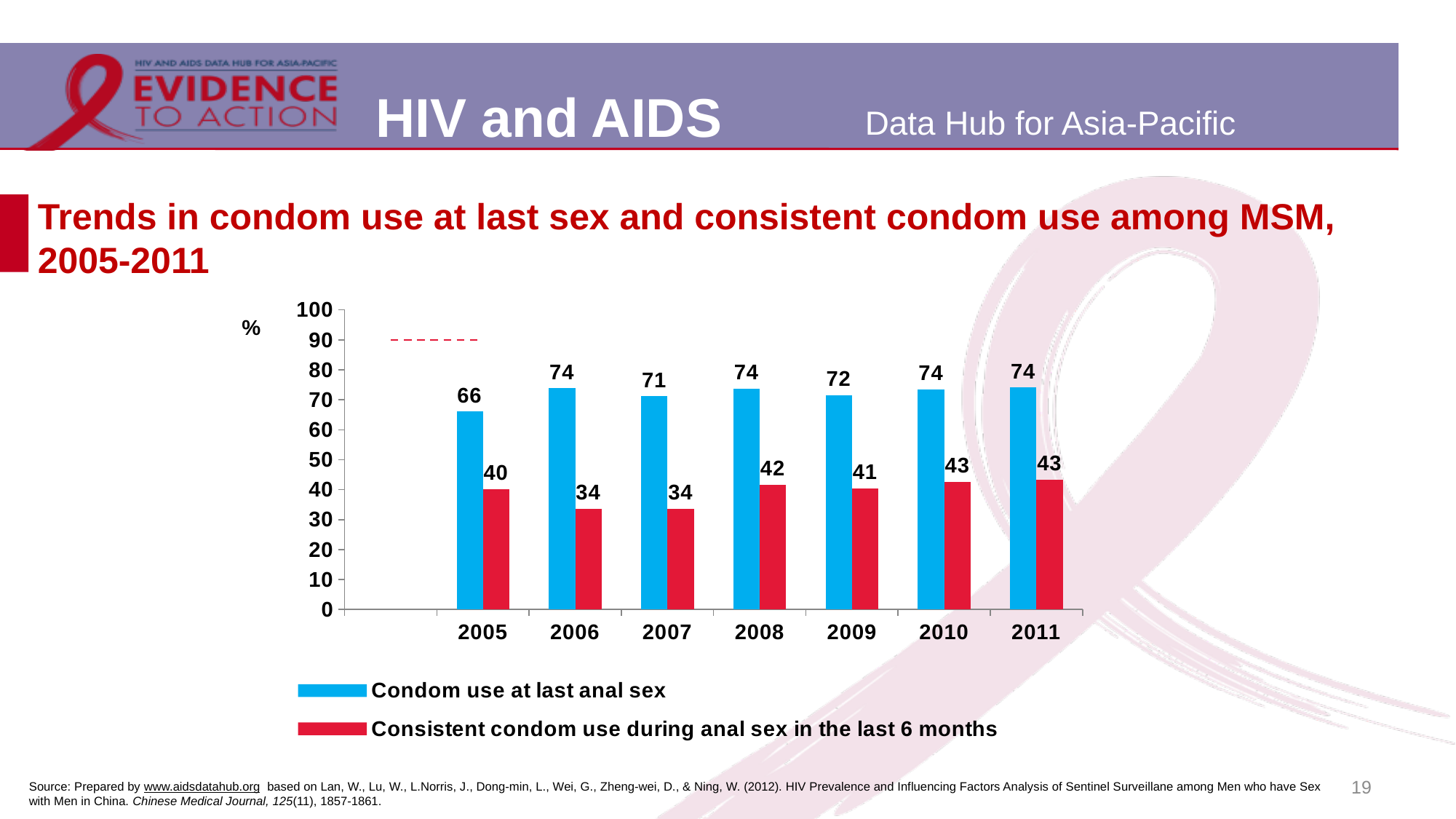
How many years are shown on the x axis? 7 What is the value for Condom use at last anal sex in 2005? 66 What is the value for Condom use at last anal sex in 2009? 72 Is the value for Condom use at last anal sex in 2010 greater or less than 60? greater What is the value for Consistent condom use during anal sex in the last 6 months in 2008? 42 What is the value for Consistent condom use during anal sex in the last 6 months in 2011? 43 In which year is Condom use at last anal sex lowest? 2005 Which is larger in 2007: Condom use at last anal sex or Consistent condom use during anal sex in the last 6 months? Condom use at last anal sex What is the difference between the 2011 and 2005 values for Consistent condom use during anal sex in the last 6 months? 3 How many series does the legend list? 2 What kind of chart is shown on the slide? Bar chart What is the difference between Condom use at last anal sex and Consistent condom use during anal sex in the last 6 months in 2006? 40